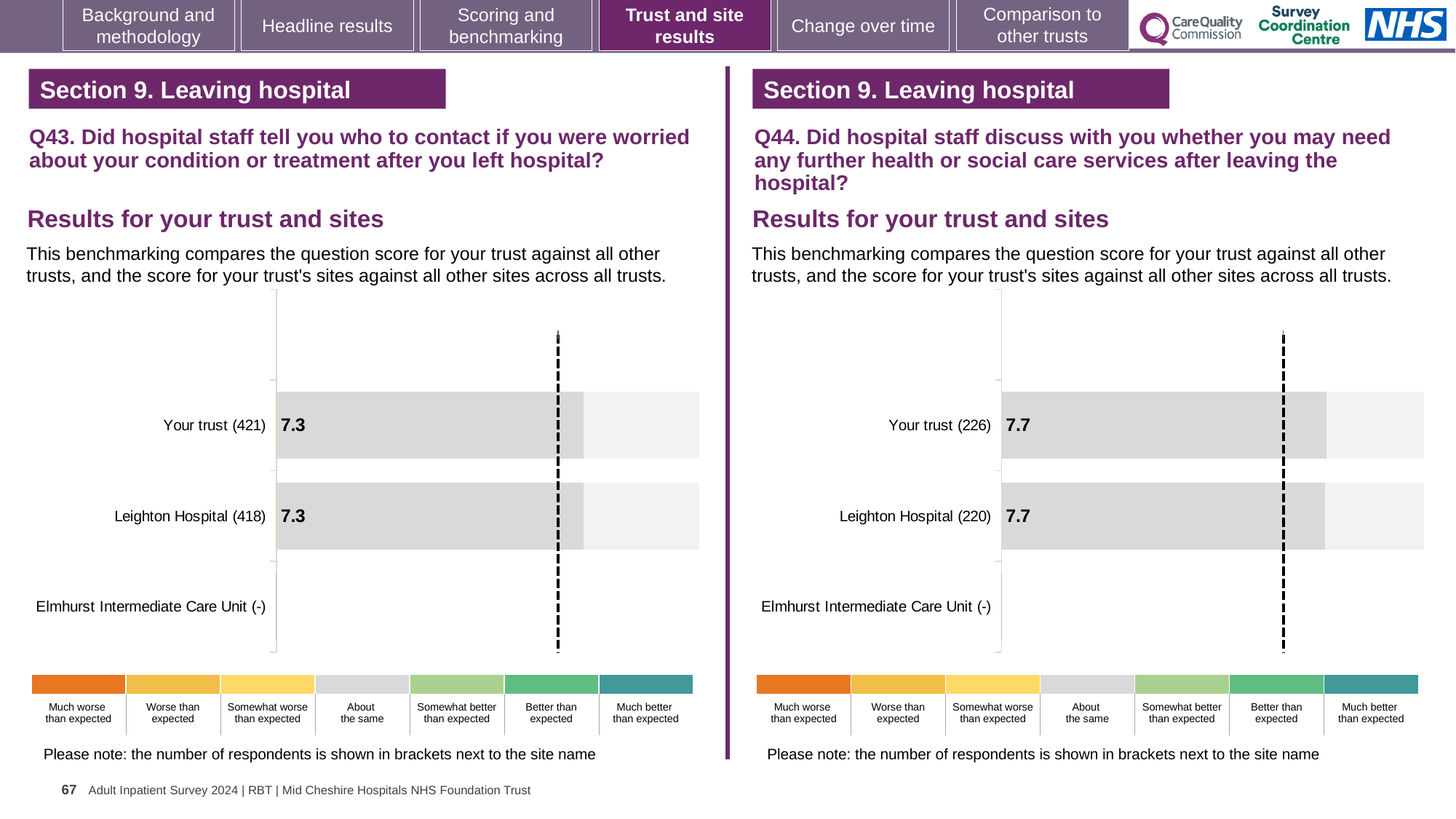
How many site/trust categories are listed on the y axis of the Q43 chart on the left? 3 In the Q44 chart on the right, what is the score for Your trust? 7.7 In the Q43 chart on the left, how many respondents are shown in brackets for Your trust? 421 In the Q44 chart on the right, how many respondents are shown in brackets for Leighton Hospital? 220 In the Q43 chart on the left, what is the difference between the scores for Your trust and Leighton Hospital? 0 In the Q43 chart on the left, what is the score for Leighton Hospital? 7.3 Is the score for Your trust in the Q44 chart on the right higher or lower than the score for Your trust in the Q43 chart on the left? Higher What kind of chart is used for the Q44 results on the right? Bar chart In the Q44 chart on the right, what is the difference between the scores for Your trust and Leighton Hospital? 0 In the Q44 chart on the right, what is the score for Leighton Hospital? 7.7 In the Q44 chart on the right, which category has no score bar shown? Elmhurst Intermediate Care Unit In the Q43 chart on the left, what is the score for Your trust? 7.3